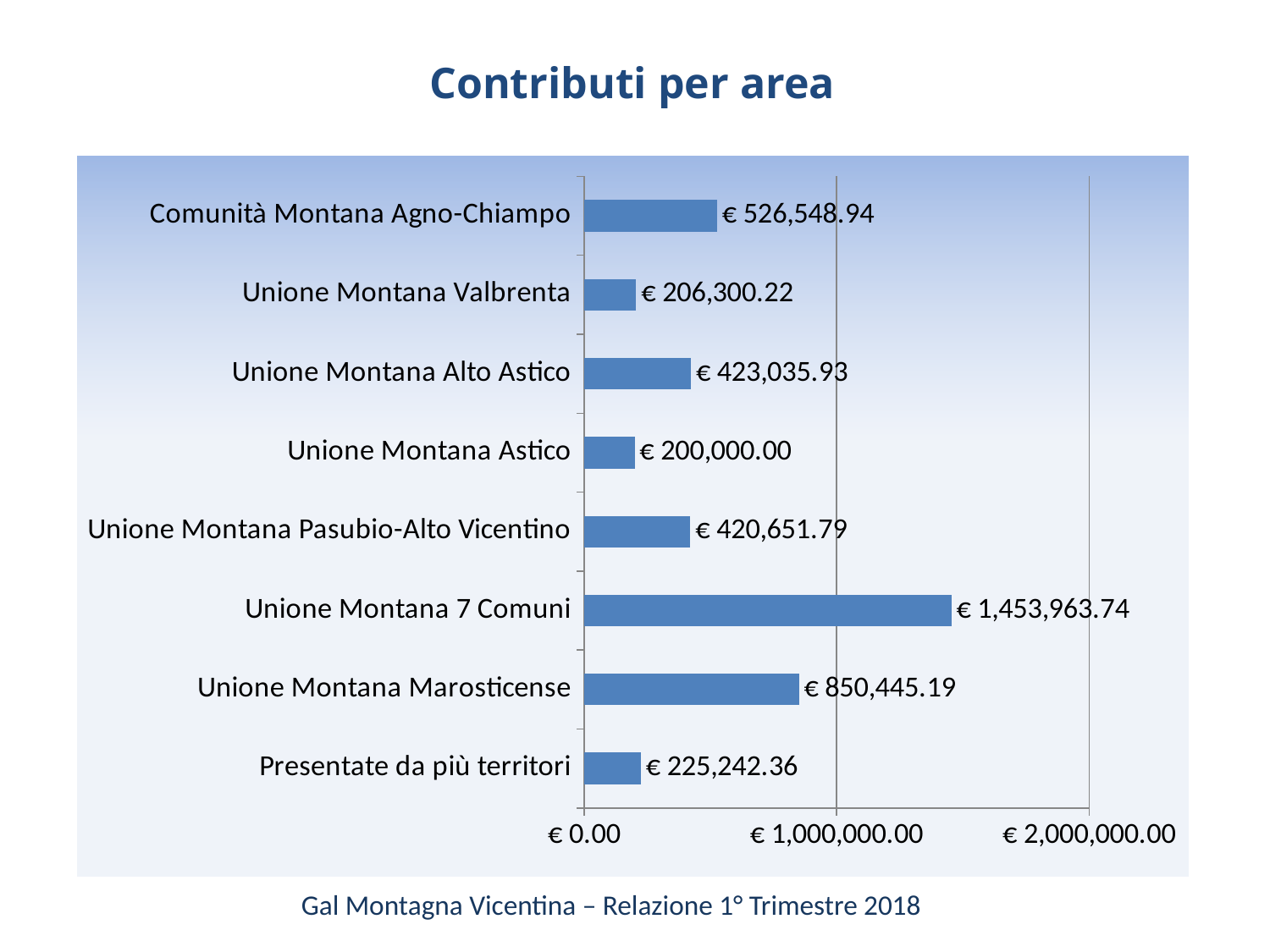
What is the difference between the values for Unione Montana 7 Comuni and Unione Montana Marosticense? € 603,518.55 What is the title of the slide? Contributi per area Which is larger, the value for Unione Montana Marosticense or the value for Comunità Montana Agno-Chiampo? Unione Montana Marosticense Which category has the highest value? Unione Montana 7 Comuni Is the value for Unione Montana Marosticense greater or less than € 1,000,000.00? less What is the value for Presentate da più territori? € 225,242.36 Which category has the lowest value? Unione Montana Astico How many categories are shown in the chart? 8 What is the value for Unione Montana Astico? € 200,000.00 What is the value for Unione Montana 7 Comuni? € 1,453,963.74 What is the value for Comunità Montana Agno-Chiampo? € 526,548.94 What type of chart is shown on the slide? bar chart